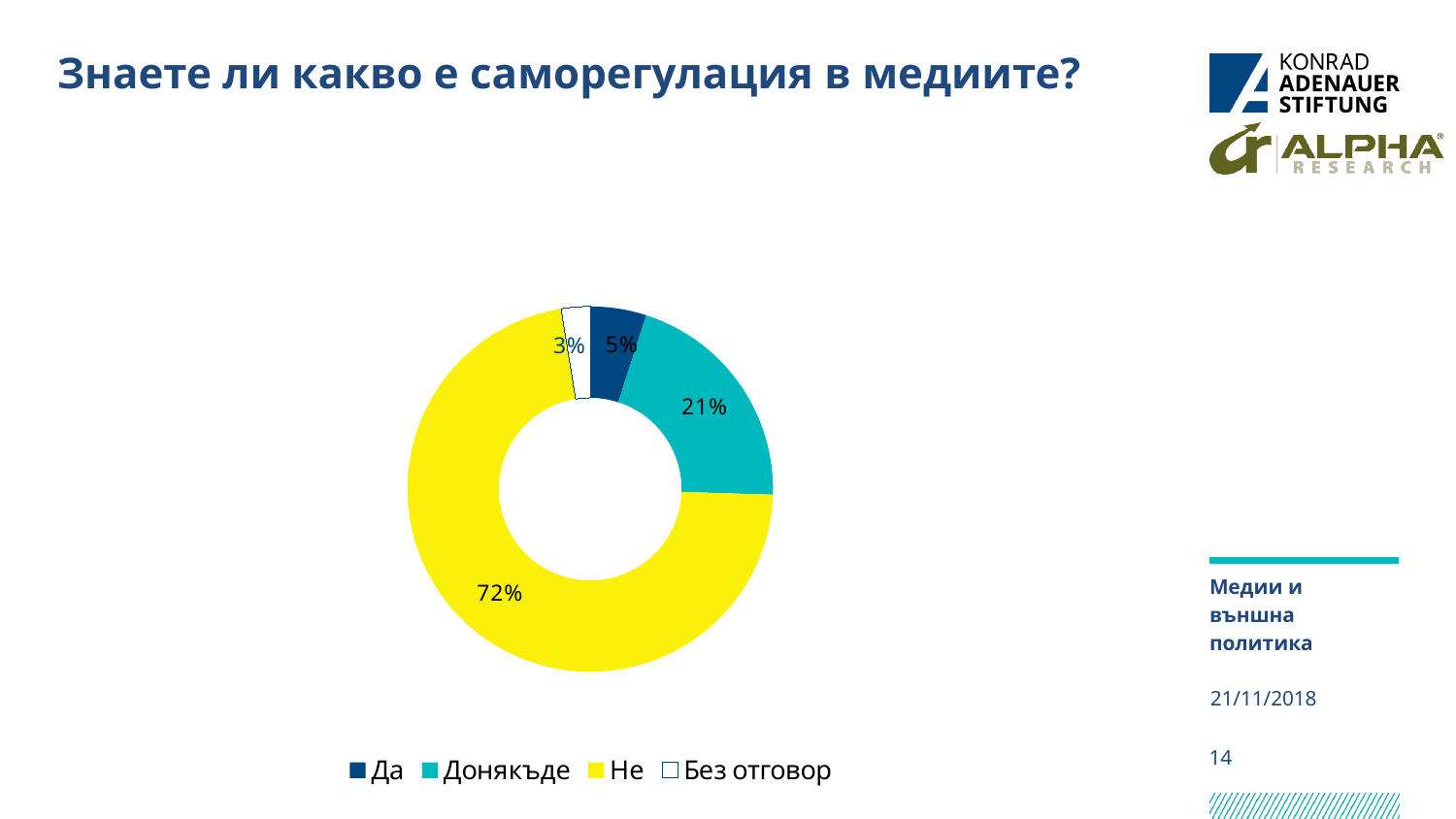
What share of respondents answered "Не"? 72% What share of respondents answered "Да"? 5% What share of respondents answered "Донякъде"? 21% What is the difference in percentage points between "Не" and "Донякъде"? 51 What share of respondents gave no answer ("Без отговор")? 3% Which answer category has the largest share? Не What is the title of the slide's chart? Знаете ли какво е саморегулация в медиите? How many answer categories does the chart show? 4 What kind of chart is shown on the slide? Doughnut chart Which is larger, the share for "Да" or the share for "Донякъде"? Донякъде Which answer category has the smallest share? Без отговор What is the combined share of "Да" and "Донякъде"? 26%